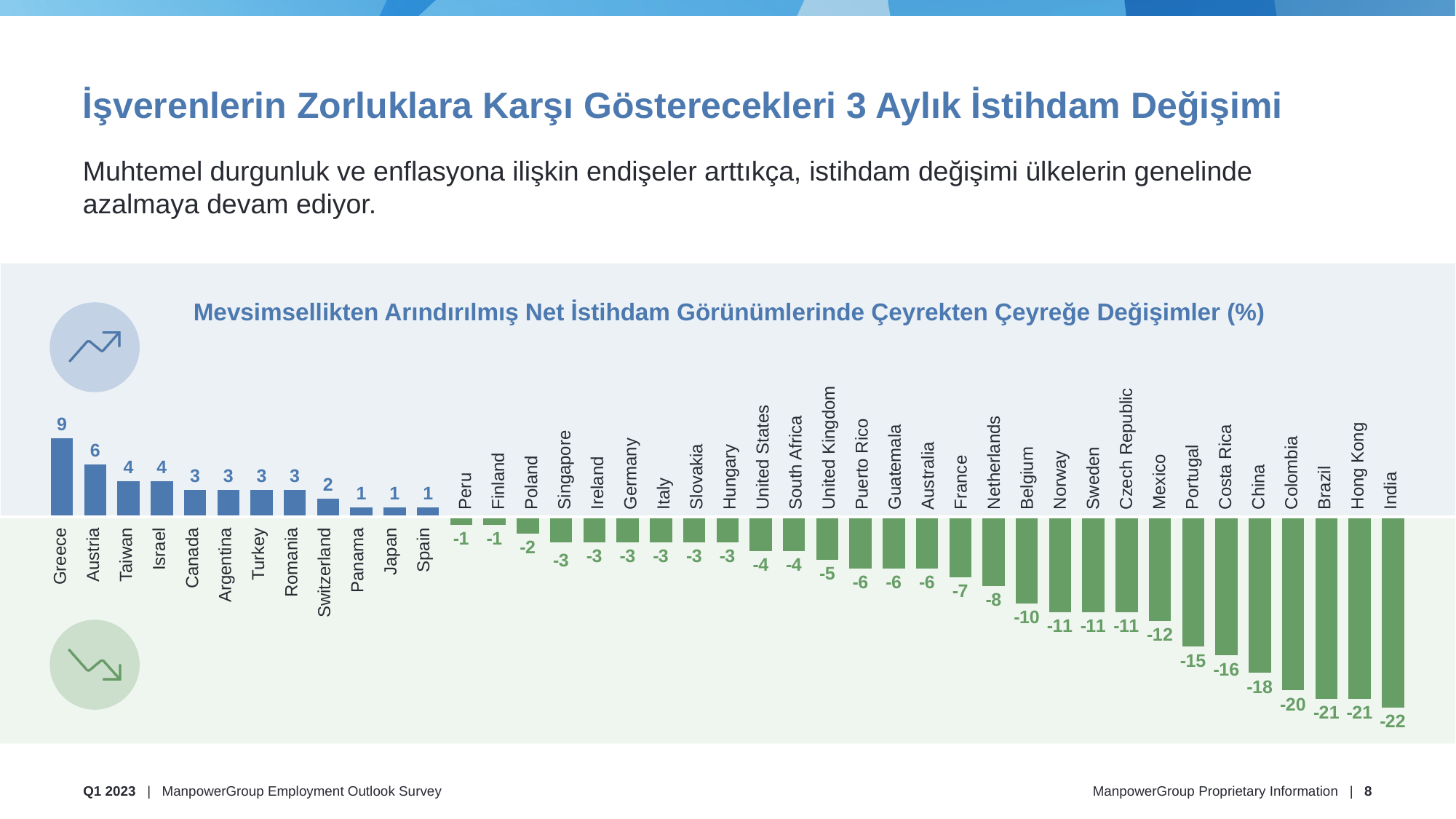
Which country has the highest value? Greece What is the difference between the values for Greece and Austria? 3 Which country has the lowest value? India What is the value for the United Kingdom? -5 How many countries are shown in the chart? 41 What is the value for India? -22 What kind of chart is shown on the slide? Bar chart Which has a larger value, Belgium or Portugal? Belgium Which has a larger value, Canada or Switzerland? Canada What is the value for Greece? 9 What is the difference between the values for China and Colombia? 2 What is the value for Mexico? -12